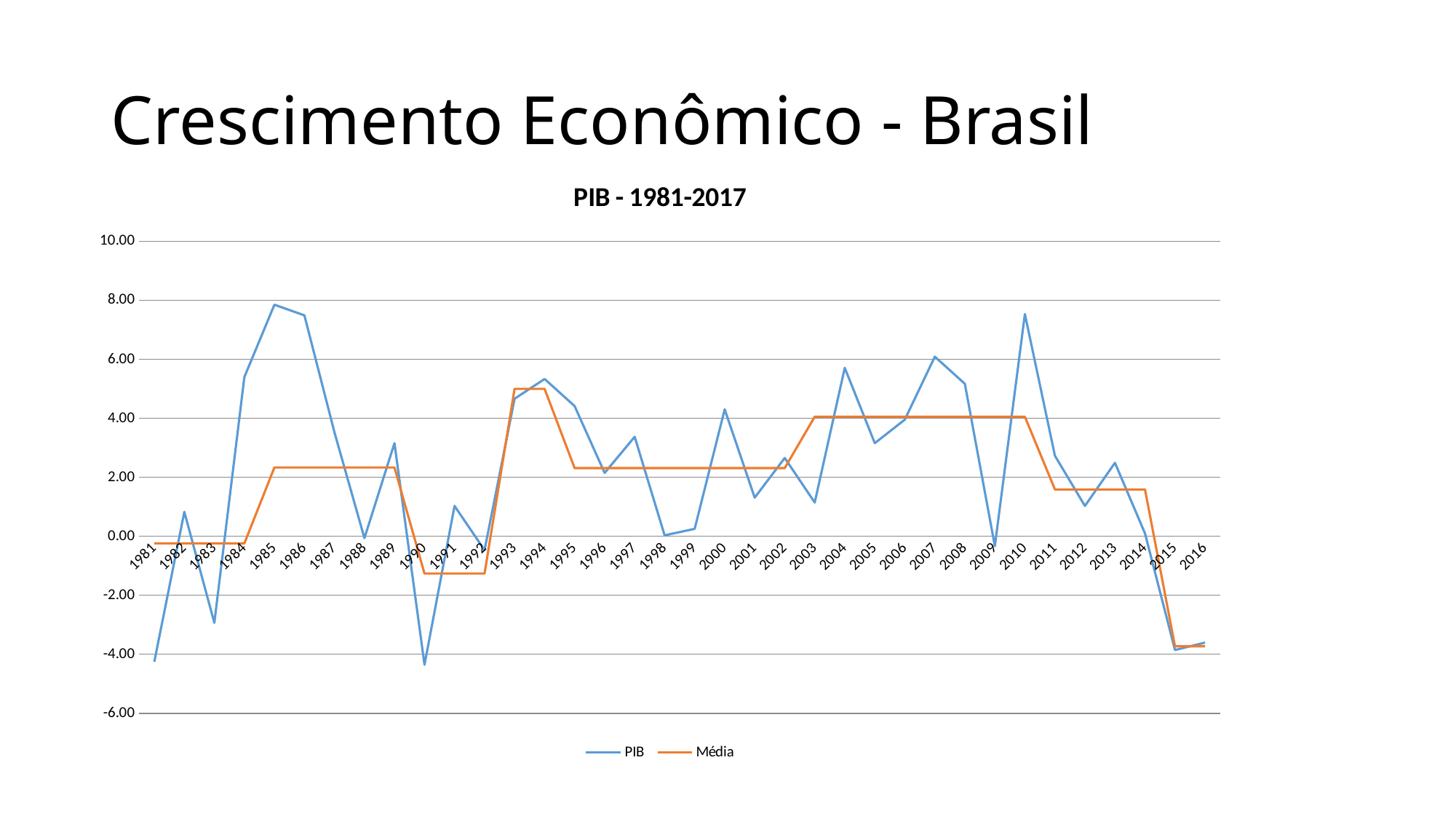
Is the PIB value for 1990 greater or less than -2.00? less What kind of chart is shown on the slide? line chart Does the PIB line rise or fall from 2010 to 2015? fall Which is larger, the PIB value for 2010 or the PIB value for 2011? 2010 What is the title of the chart? PIB - 1981-2017 How many years are shown on the x axis? 36 How many series does the legend list? 2 Is the Média value for 1991 greater or less than 0.00? less Is the PIB value for 1985 greater or less than 6.00? greater Which series is drawn in orange? Média